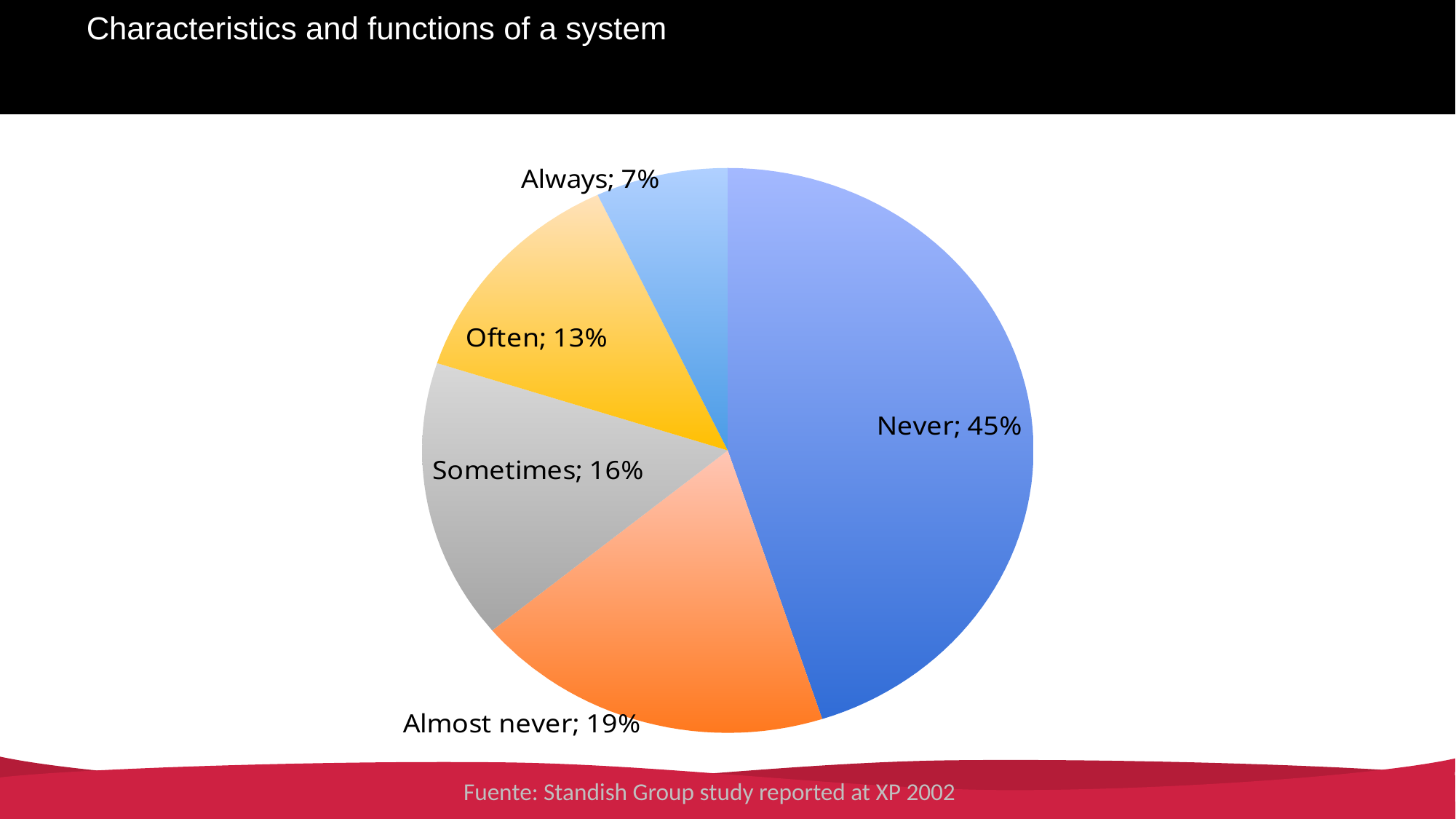
How many slices does the pie chart have? 5 Which slice of the pie is the smallest? Always What percentage is shown for the Never slice? 45% What source is cited at the bottom of the slide? Standish Group study reported at XP 2002 Which is larger, the Sometimes slice or the Often slice? Sometimes What percentage is shown for the Often slice? 13% What percentage is shown for the Almost never slice? 19% What percentage is shown for the Sometimes slice? 16% What percentage is shown for the Always slice? 7% What is the difference in percentage points between the Never and Almost never slices? 26 What kind of chart is shown on the slide? pie chart Which slice of the pie is the largest? Never